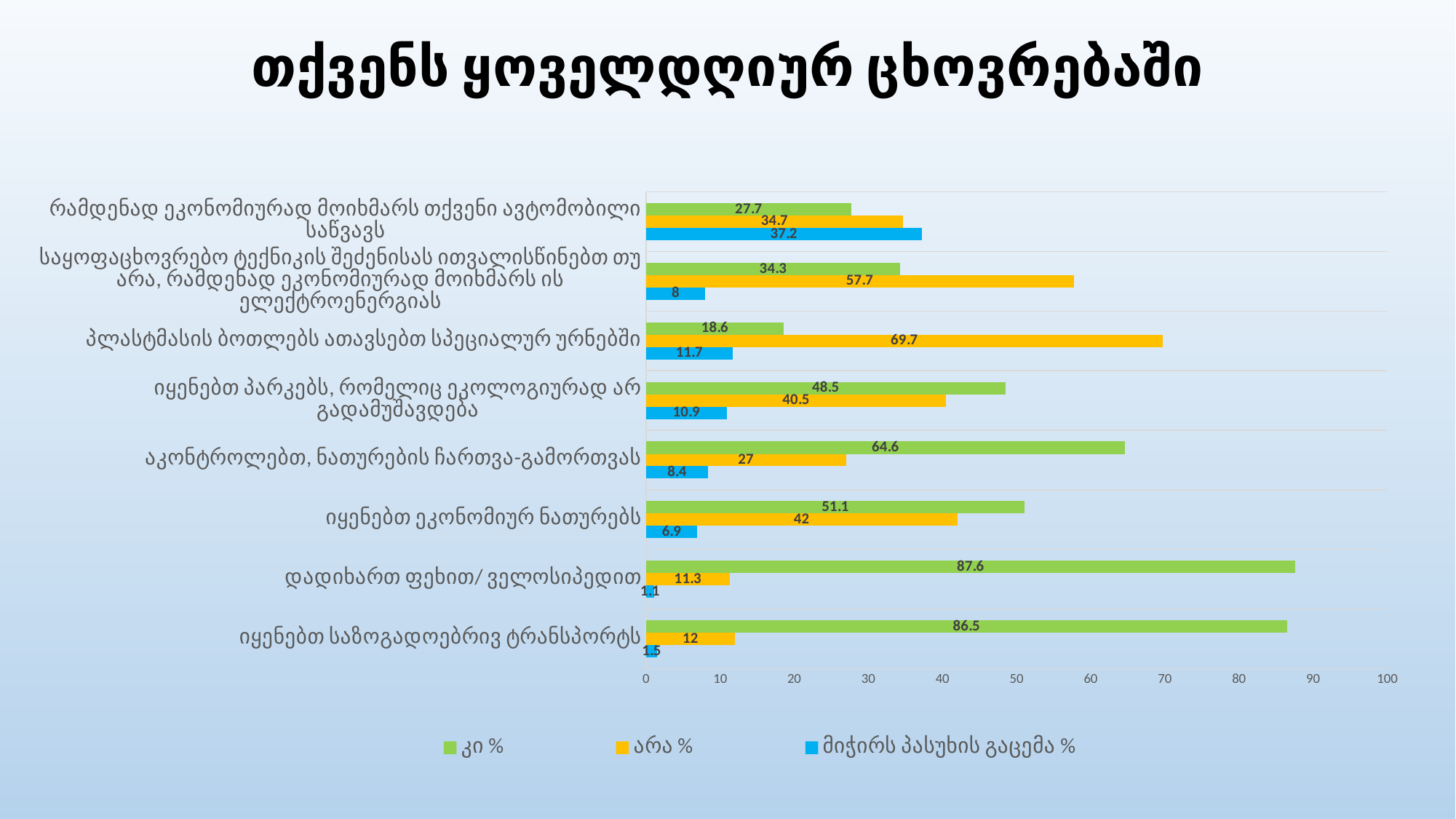
How many series does the legend list? 3 Is the არა % value for "საყოფაცხოვრებო ტექნიკის შეძენისას ითვალისწინებთ თუ არა, რამდენად ეკონომიურად მოიხმარს ის ელექტროენერგიას" greater or less than 50? greater What is the value of არა % for "პლასტმასის ბოთლებს ათავსებთ სპეციალურ ურნებში"? 69.7 What is the value of მიჭირს პასუხის გაცემა % for "რამდენად ეკონომიურად მოიხმარს თქვენი ავტომობილი საწვავს"? 37.2 What is the difference between კი % and არა % for "აკონტროლებთ, ნათურების ჩართვა-გამორთვას"? 37.6 For "იყენებთ პარკებს, რომელიც ეკოლოგიურად არ გადამუშავდება", which is larger: კი % or არა %? კი % Which category has the lowest კი % value? პლასტმასის ბოთლებს ათავსებთ სპეციალურ ურნებში Which category has the highest კი % value? დადიხართ ფეხით/ ველოსიპედით What colour represents the არა % series? yellow What type of chart is shown on the slide? bar chart What is the value of კი % for "დადიხართ ფეხით/ ველოსიპედით"? 87.6 How many categories are shown on the chart? 8